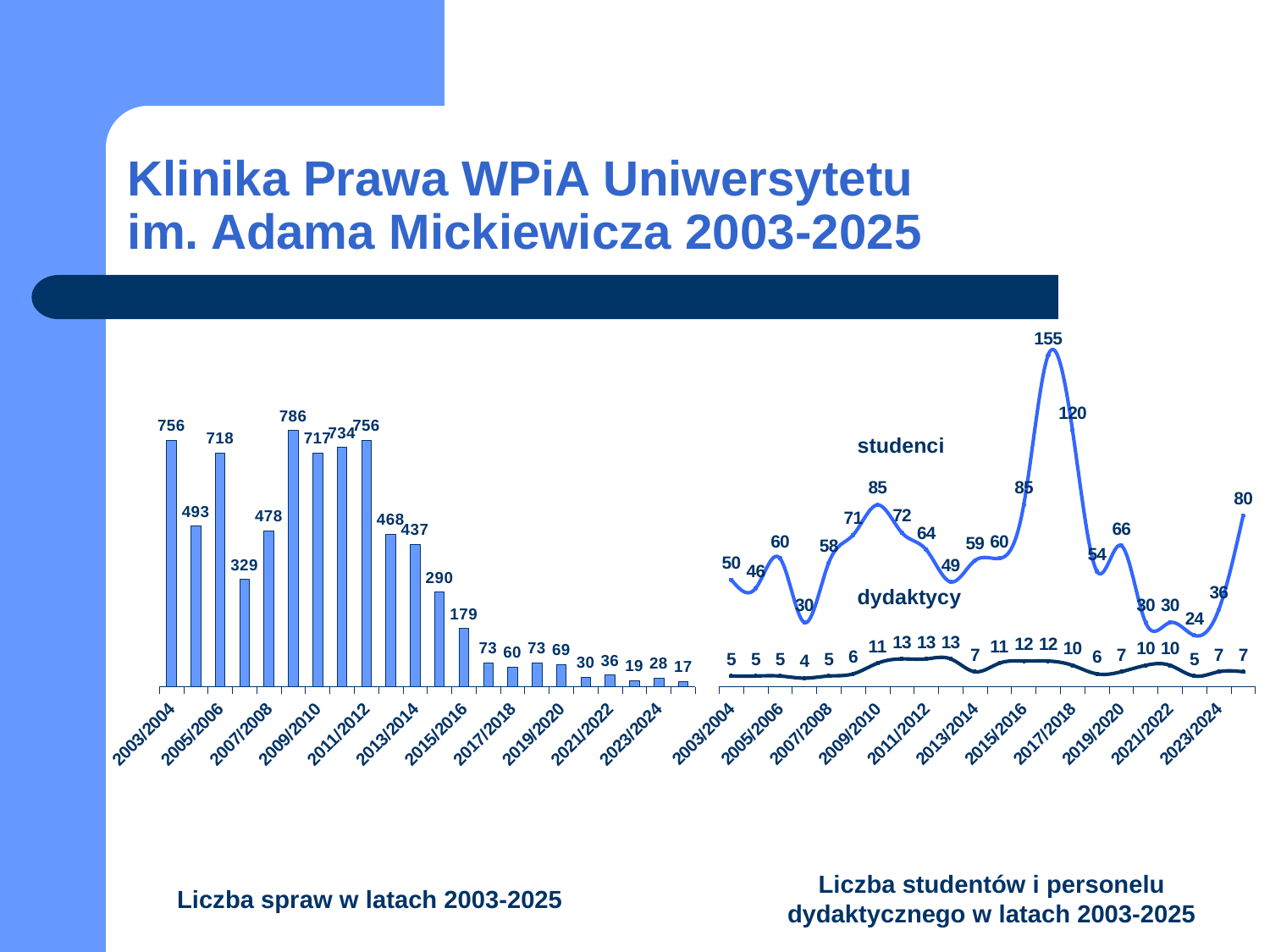
In the right chart, what is the difference between the two highest 'studenci' values, 155 and 120? 35 In the left chart 'Liczba spraw w latach 2003-2025', how many bars are plotted? 22 In the left chart 'Liczba spraw w latach 2003-2025', what is the lowest value shown? 17 In the right chart, what is the highest value of the 'studenci' series? 155 In the left chart 'Liczba spraw w latach 2003-2025', what is the highest value shown? 786 In the right chart, what is the lowest value of the 'dydaktycy' series? 4 In the left chart 'Liczba spraw w latach 2003-2025', do the values overall rise or fall from 2003/2004 to 2024/2025? fall In the left chart 'Liczba spraw w latach 2003-2025', what is the value for 2003/2004? 756 What kind of chart is the left chart, 'Liczba spraw w latach 2003-2025'? bar chart What kind of chart is the right chart, 'Liczba studentów i personelu dydaktycznego w latach 2003-2025'? line chart In the left chart 'Liczba spraw w latach 2003-2025', which is larger: the value for 2003/2004 or the value for 2005/2006? 2003/2004 In the right chart, how many series are plotted? 2